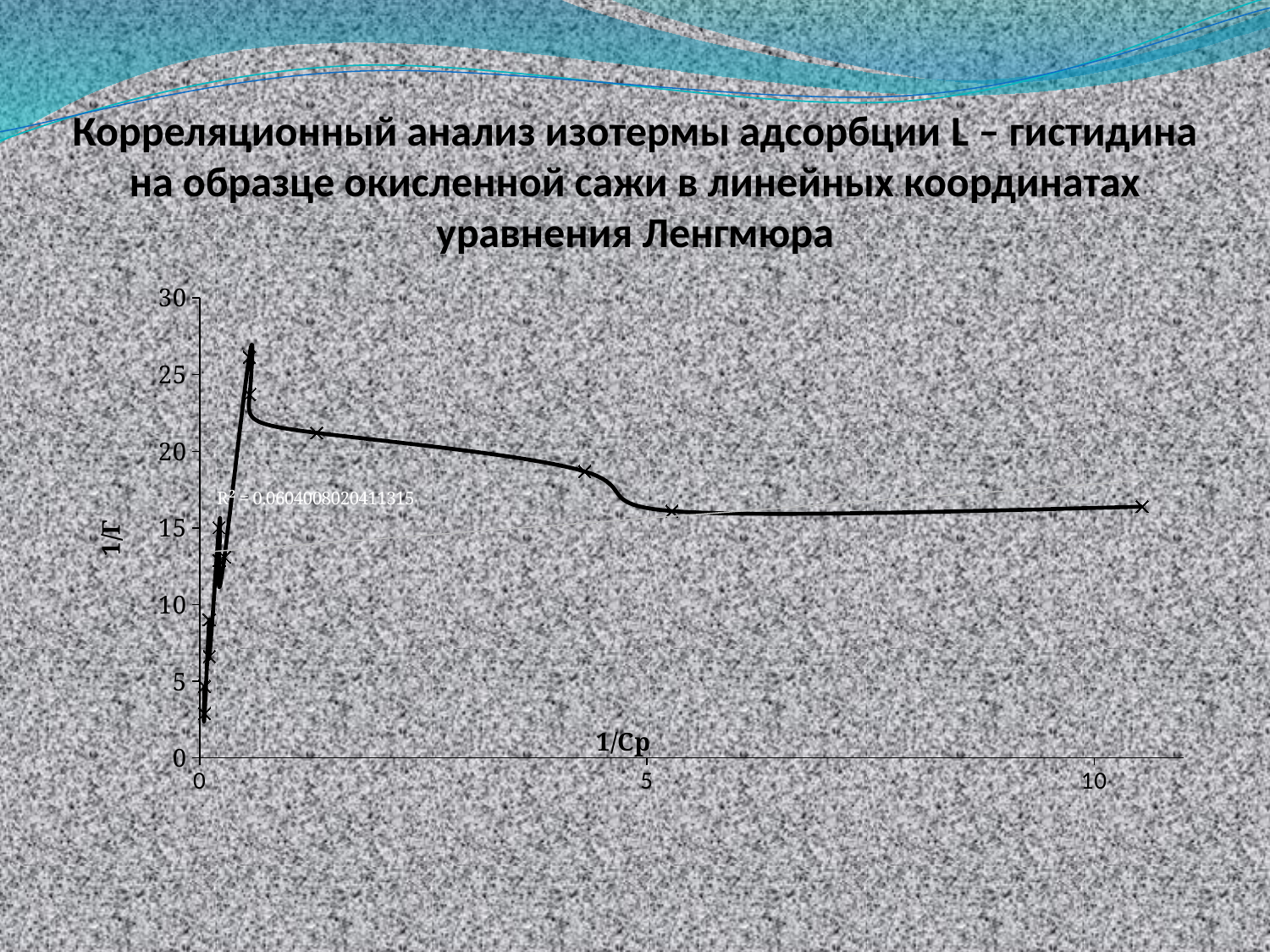
Does the highest 1/Г value occur at a small or a large value of 1/Cp? small Is the lowest 1/Г value on the chart greater or less than 5? less Is the value of 1/Г for the rightmost point (at 1/Cp of about 10.5) greater or less than 20? less Which point has the larger 1/Г value: the one at 1/Cp of about 4.3 or the one at 1/Cp of about 5.3? the one at 1/Cp of about 4.3 Is the value of 1/Г for the point at 1/Cp of about 1.5 greater or less than 20? greater What kind of chart is shown on the slide? line chart Does the curve rise or fall as 1/Cp increases from about 1.5 to 10? fall What is the label of the x axis of the chart? 1/Cp What R² value is printed on the chart? R² = 0.0604008020411315